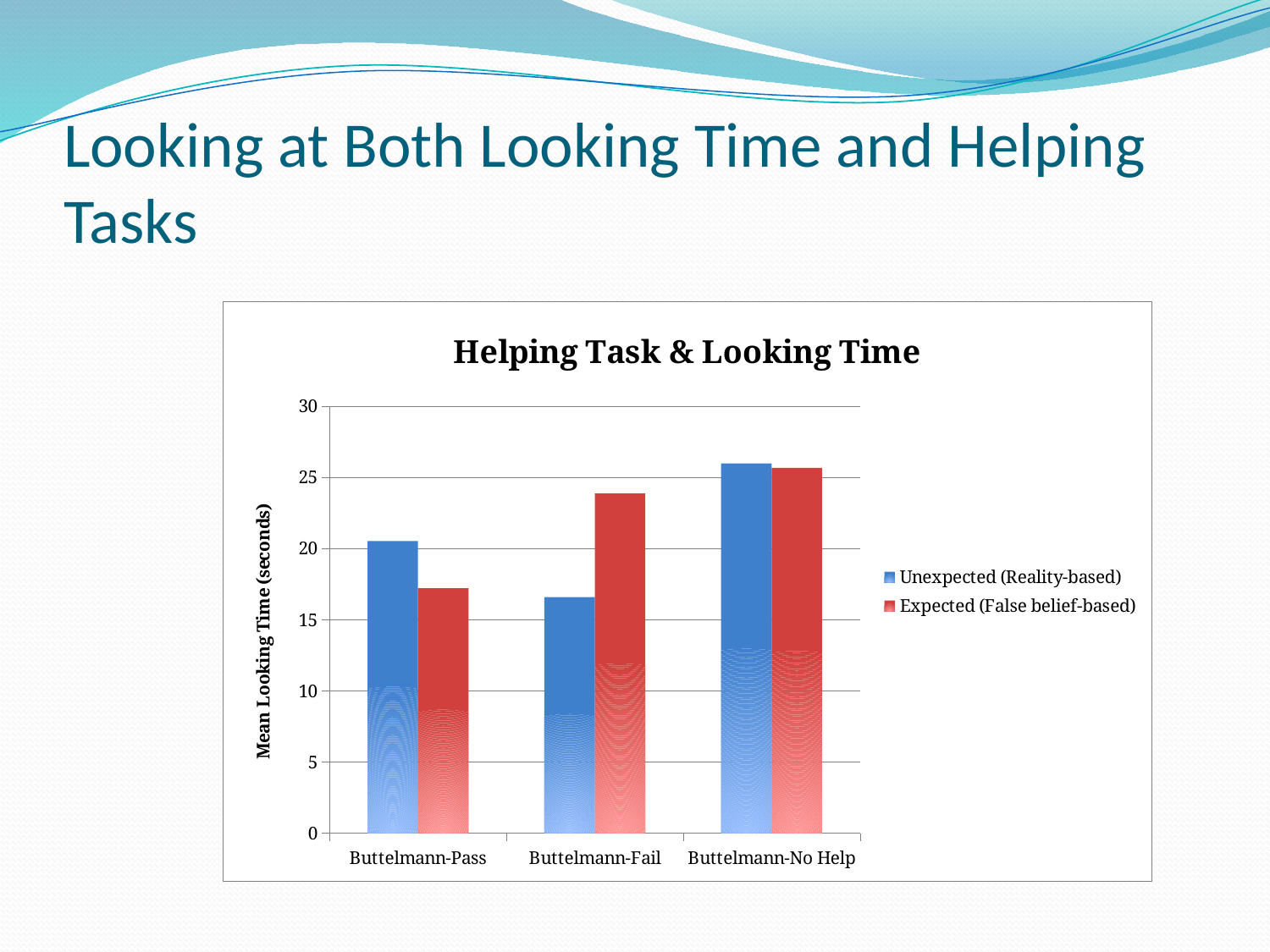
For Buttelmann-Pass, which series has the larger value, Unexpected (Reality-based) or Expected (False belief-based)? Unexpected (Reality-based) What is the y-axis label of the chart? Mean Looking Time (seconds) How many categories are shown on the x axis? 3 What kind of chart is shown on the slide? bar chart Which category has the highest value for the Unexpected (Reality-based) series? Buttelmann-No Help How many series does the legend list? 2 What is the title of the chart? Helping Task & Looking Time Which category has the lowest value for the Unexpected (Reality-based) series? Buttelmann-Fail Which category has the lowest value for the Expected (False belief-based) series? Buttelmann-Pass For Buttelmann-Fail, which series has the larger value, Unexpected (Reality-based) or Expected (False belief-based)? Expected (False belief-based) Is the value for Unexpected (Reality-based) at Buttelmann-Fail greater or less than 20? less Is the value for Expected (False belief-based) at Buttelmann-Fail greater or less than 20? greater